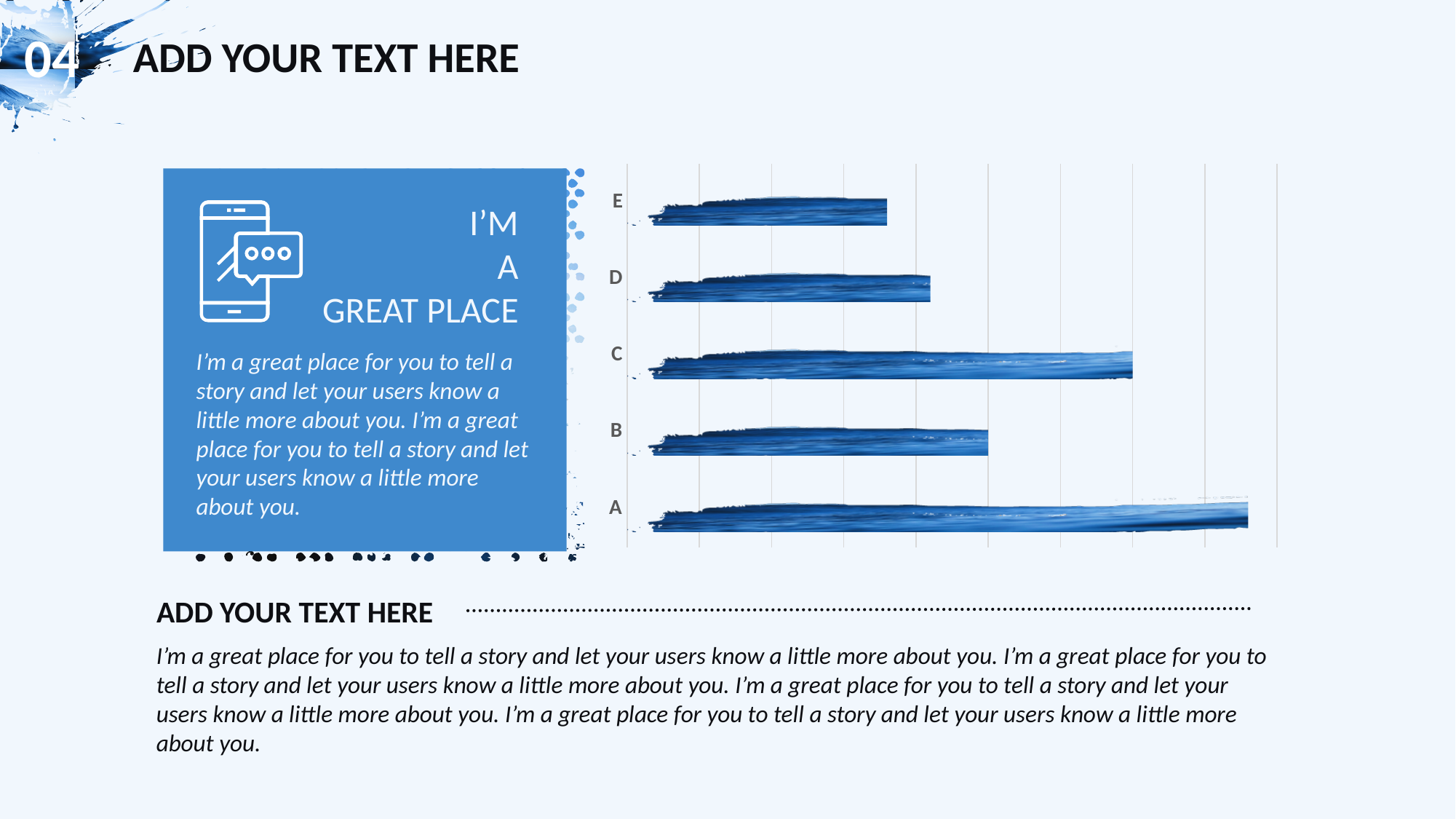
Are the bars in the chart drawn horizontally or vertically? Horizontally Which bar is longer, C or B? C Which category label appears at the top of the chart? E Which bar is longer, E or C? C Which category has the longest bar in the chart? A How many categories does the bar chart show? 5 Which category has the shortest bar in the chart? E What kind of chart is shown on the slide? Bar chart Which category has the second-longest bar in the chart? C Which bar is longer, A or C? A